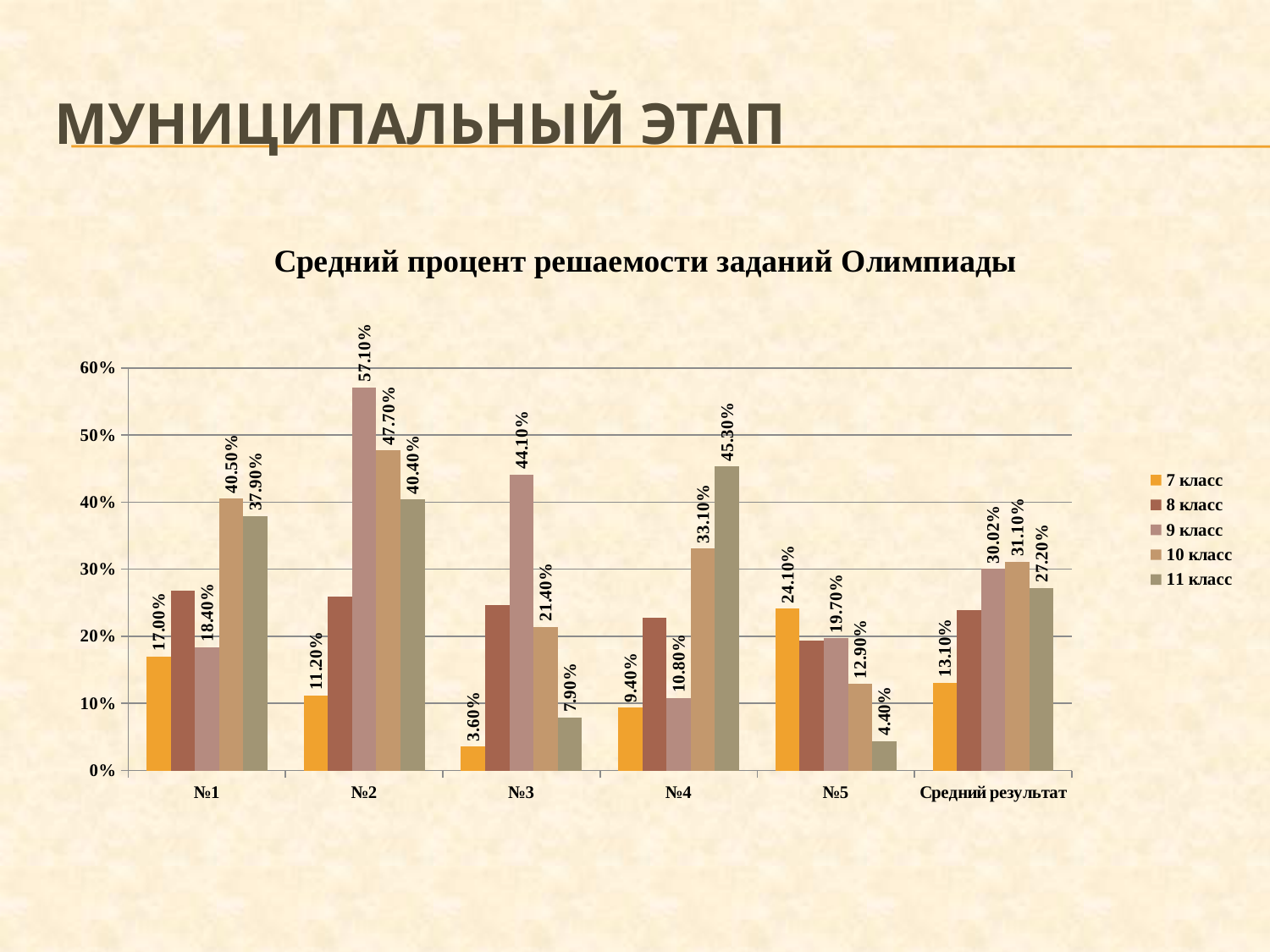
What is the value for 11 класс at №4? 45.30% What is the difference between the 10 класс and 9 класс values at №1? 22.10% In which category does 9 класс have its highest value? №2 What is the value for 7 класс at №3? 3.60% How many series does the legend list? 5 Is the value for 8 класс at №1 greater or less than 20%? greater What is the value for 10 класс in the Средний результат category? 31.10% Which is larger for 7 класс: the value at №5 or the value at №1? №5 What is the value for 9 класс at №2? 57.10% How many categories are shown on the x axis? 6 What kind of chart is shown on the slide? bar chart In which category does 11 класс have its lowest value? №5